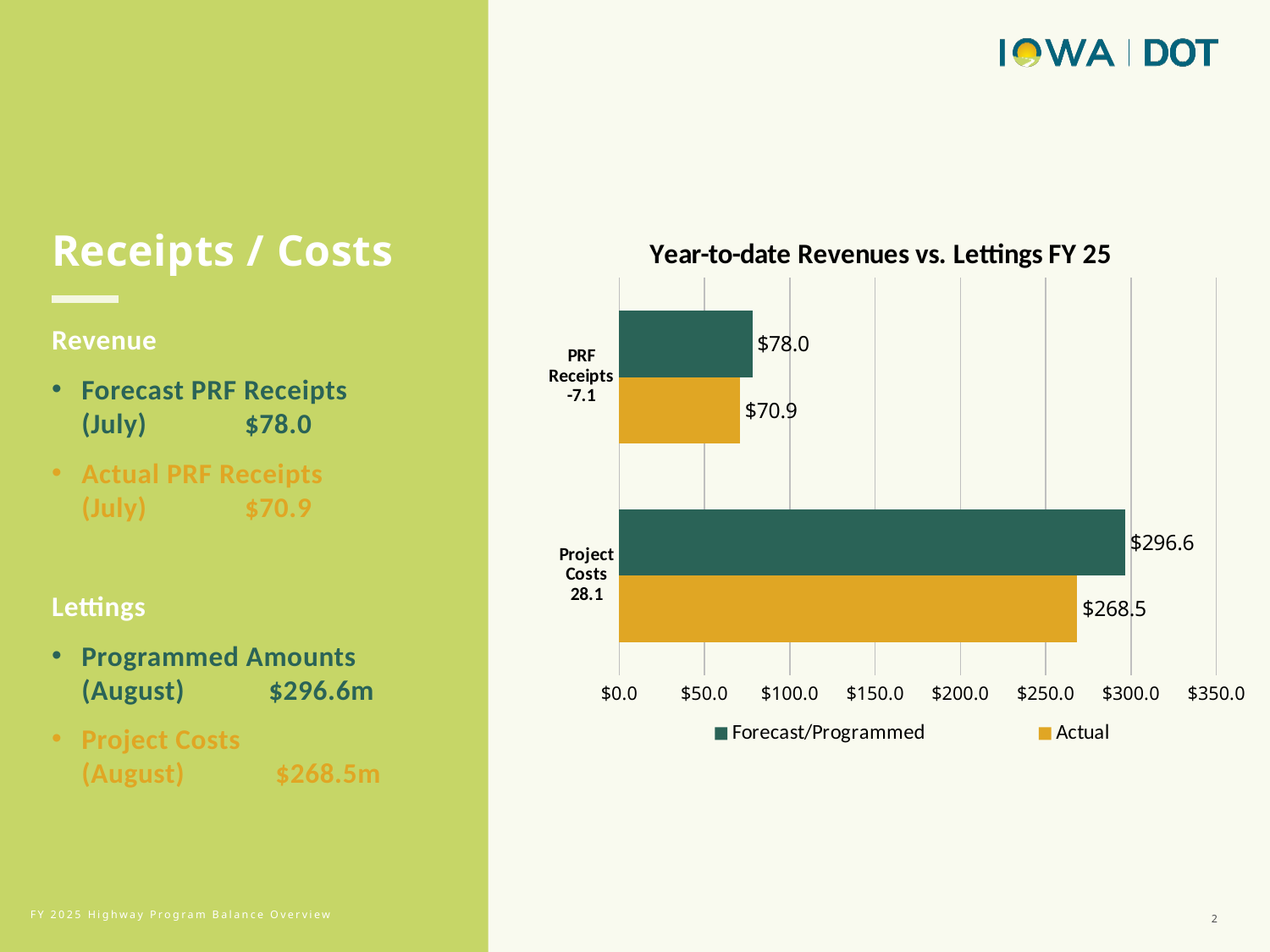
What is the title of the chart? Year-to-date Revenues vs. Lettings FY 25 What is the difference between the Forecast/Programmed and Actual values for Project Costs? $28.1 What is the Actual value for Project Costs? $268.5 What is the difference between the Forecast/Programmed and Actual values for PRF Receipts? $7.1 What kind of chart is shown on the slide? Bar chart What is the Forecast/Programmed value for Project Costs? $296.6 Which category has the lowest Actual value? PRF Receipts How many series does the legend list? 2 Which is larger for PRF Receipts, the Forecast/Programmed value or the Actual value? Forecast/Programmed What is the Forecast/Programmed value for PRF Receipts? $78.0 What is the Actual value for PRF Receipts? $70.9 Which category has the highest Forecast/Programmed value? Project Costs